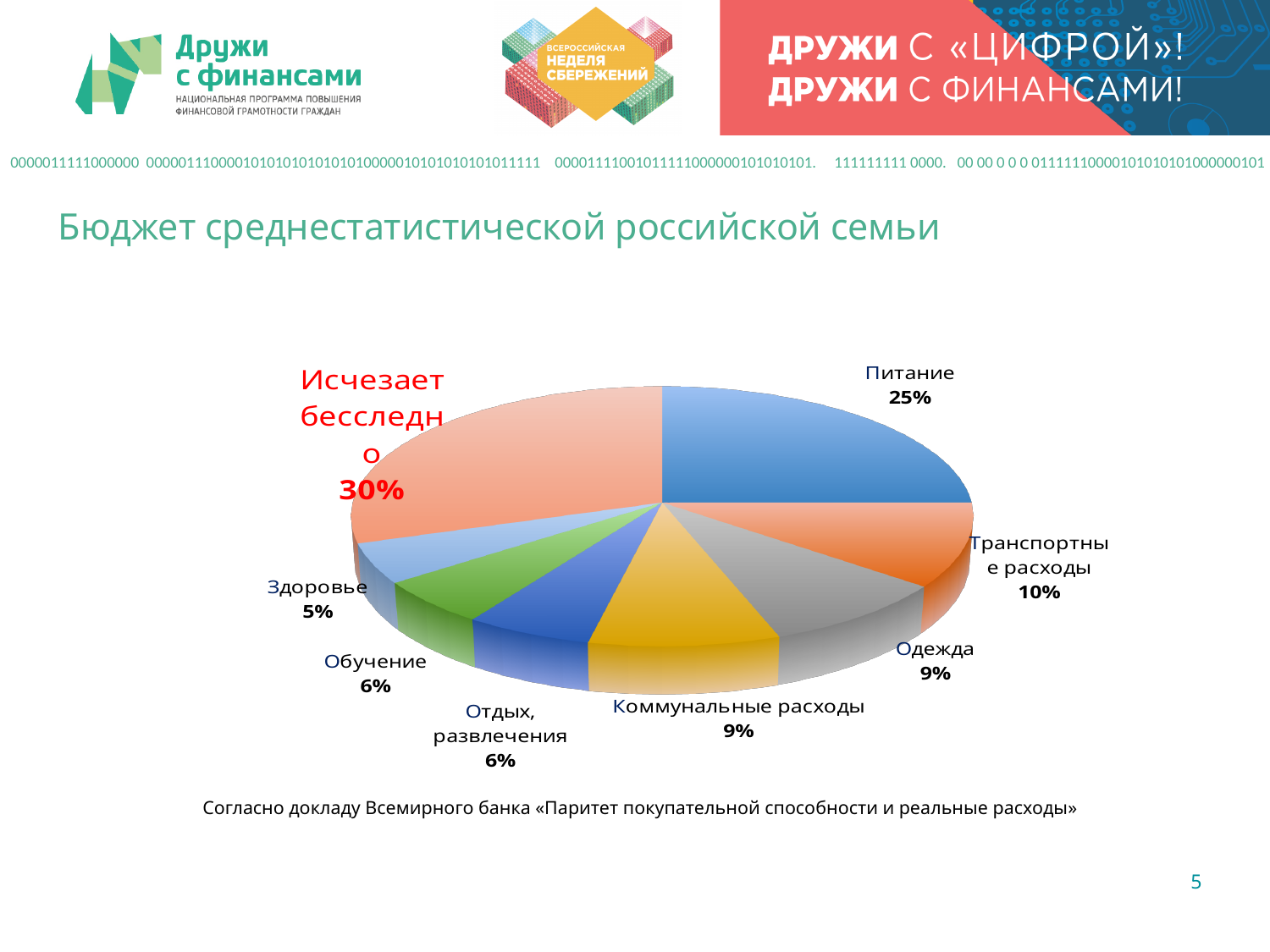
How many categories are shown in the pie chart? 8 What share of the budget is labelled Исчезает бесследно? 30% What share of the budget goes to Здоровье? 5% What share of the budget goes to Транспортные расходы? 10% What is the difference between the shares for Питание and Транспортные расходы? 15% Which category has the smallest share of the budget? Здоровье Which category has the largest share of the budget? Исчезает бесследно What share of the budget goes to Питание? 25% What kind of chart is shown on the slide? pie chart What is the title of the chart on the slide? Бюджет среднестатистической российской семьи What share of the budget goes to Коммунальные расходы? 9% Which is larger, the share for Одежда or the share for Обучение? Одежда